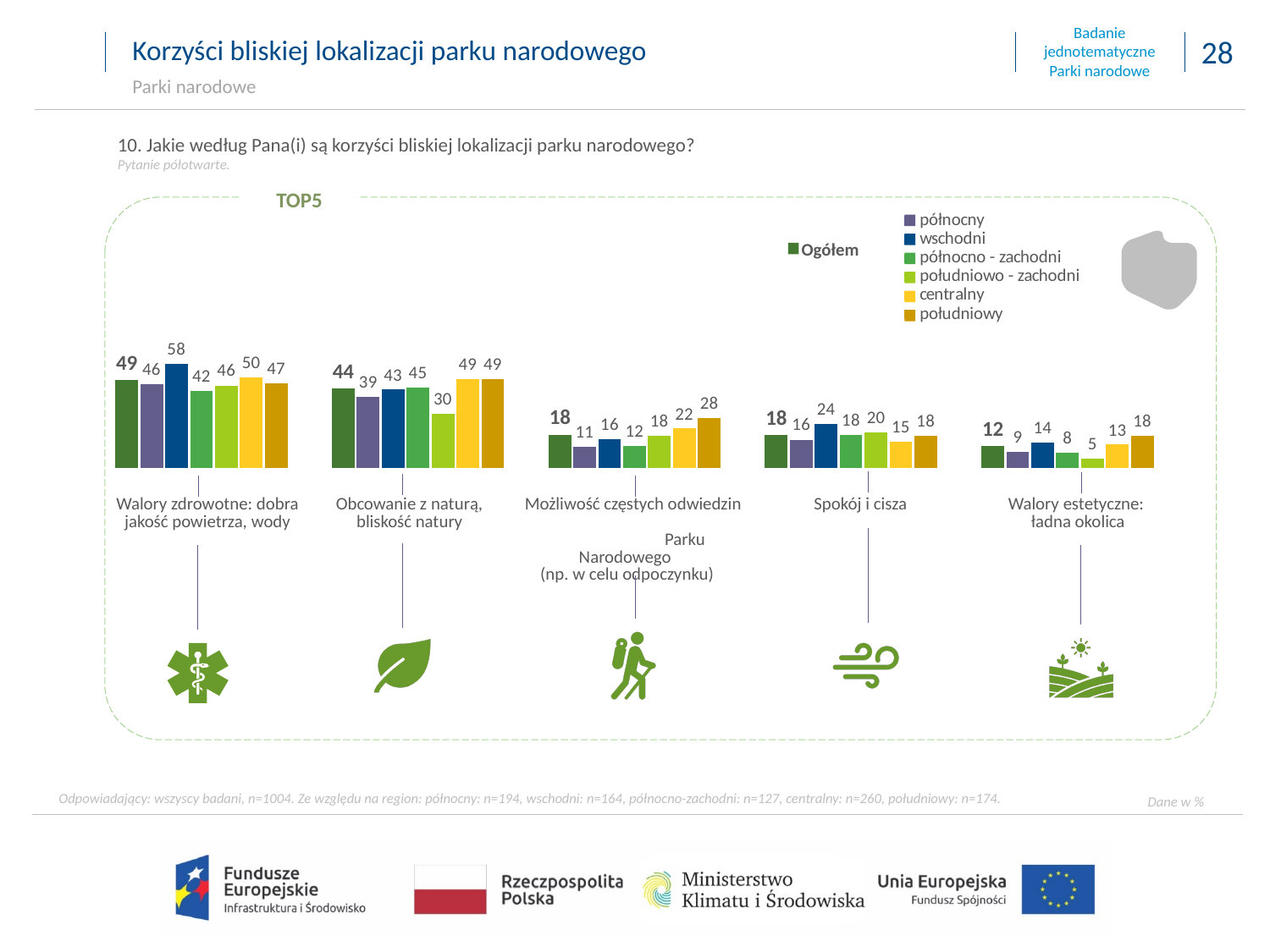
What type of chart is shown on the slide? bar chart What is the value for the wschodni region for 'Walory zdrowotne: dobra jakość powietrza, wody'? 58 What is the value for the południowo - zachodni region for 'Obcowanie z naturą, bliskość natury'? 30 What is the value for the południowy region for 'Możliwość częstych odwiedzin Parku Narodowego'? 28 Which category has the highest Ogółem value? Walory zdrowotne: dobra jakość powietrza, wody Which is larger for 'Walory estetyczne: ładna okolica': the południowy value or the północny value? południowy What is the difference between the wschodni and północno - zachodni values for 'Walory zdrowotne: dobra jakość powietrza, wody'? 16 Which category has the lowest Ogółem value? Walory estetyczne: ładna okolica Which region has the highest value for 'Spokój i cisza'? wschodni How many regions are listed in the regional legend? 6 What is the Ogółem value for 'Walory zdrowotne: dobra jakość powietrza, wody'? 49 How many categories are shown on the chart? 5